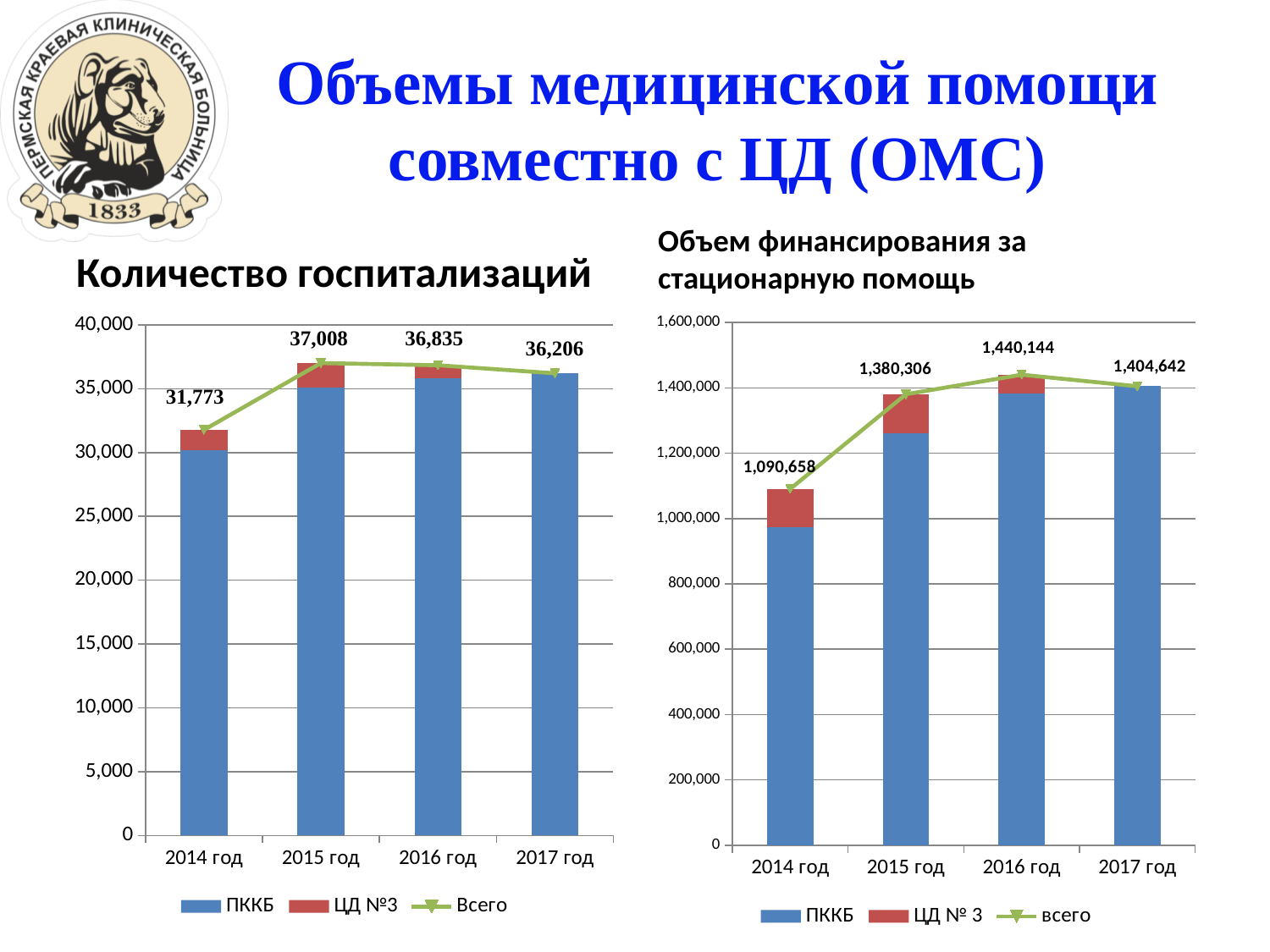
In the 'Количество госпитализаций' chart, which year has the highest total? 2015 год In the 'Объем финансирования за стационарную помощь' chart, how many years are shown on the x axis? 4 In the 'Объем финансирования за стационарную помощь' chart, which year has the lowest total? 2014 год In the 'Количество госпитализаций' chart, what is the difference between the totals for 2015 год and 2014 год? 5,235 In the 'Количество госпитализаций' chart, which total is larger: 2016 год or 2017 год? 2016 год In the 'Объем финансирования за стационарную помощь' chart, what is the total (всего) value for 2017 год? 1,404,642 In the 'Количество госпитализаций' chart, what is the total (Всего) value for 2015 год? 37,008 In the 'Объем финансирования за стационарную помощь' chart, what is the total (всего) value for 2016 год? 1,440,144 In the 'Количество госпитализаций' chart, what is the total (Всего) value for 2014 год? 31,773 In the 'Объем финансирования за стационарную помощь' chart, what is the difference between the totals for 2016 год and 2014 год? 349,486 How many series does the legend of the 'Количество госпитализаций' chart list? 3 In the 'Объем финансирования за стационарную помощь' chart, is the ПККБ value for 2014 год greater or less than 1,000,000? less